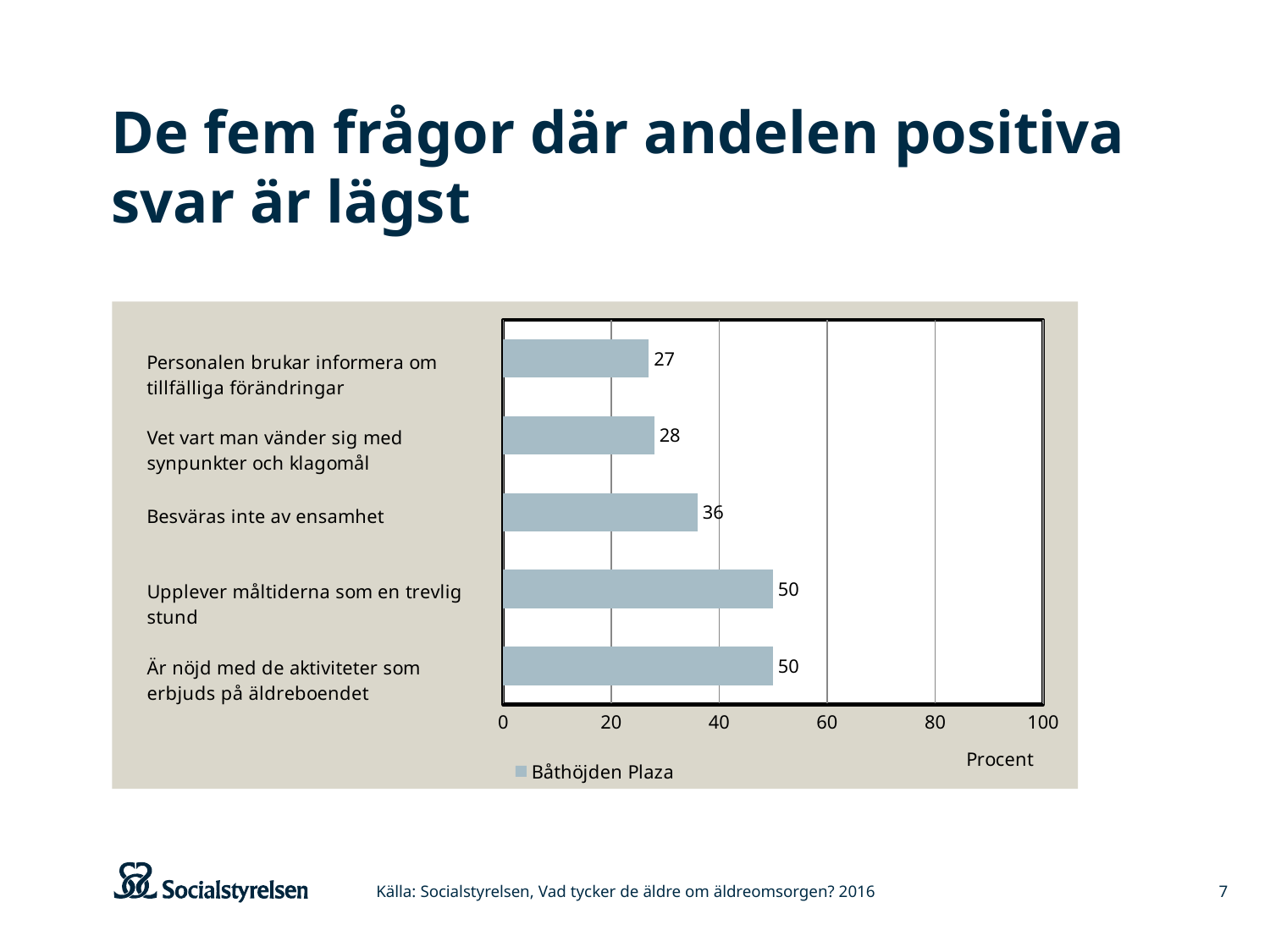
How many series does the legend list? 1 What is the difference between the values for "Besväras inte av ensamhet" and "Personalen brukar informera om tillfälliga förändringar"? 9 Which category has the lowest value? Personalen brukar informera om tillfälliga förändringar What is the value for "Upplever måltiderna som en trevlig stund"? 50 What is the value for "Vet vart man vänder sig med synpunkter och klagomål"? 28 What is the difference between the values for "Är nöjd med de aktiviteter som erbjuds på äldreboendet" and "Vet vart man vänder sig med synpunkter och klagomål"? 22 What kind of chart is shown on the slide? bar chart Is the value for "Besväras inte av ensamhet" greater or less than 40? less What is the value for "Personalen brukar informera om tillfälliga förändringar"? 27 Which is larger, the value for "Besväras inte av ensamhet" or the value for "Vet vart man vänder sig med synpunkter och klagomål"? Besväras inte av ensamhet What is the value for "Besväras inte av ensamhet"? 36 How many categories are shown in the chart? 5